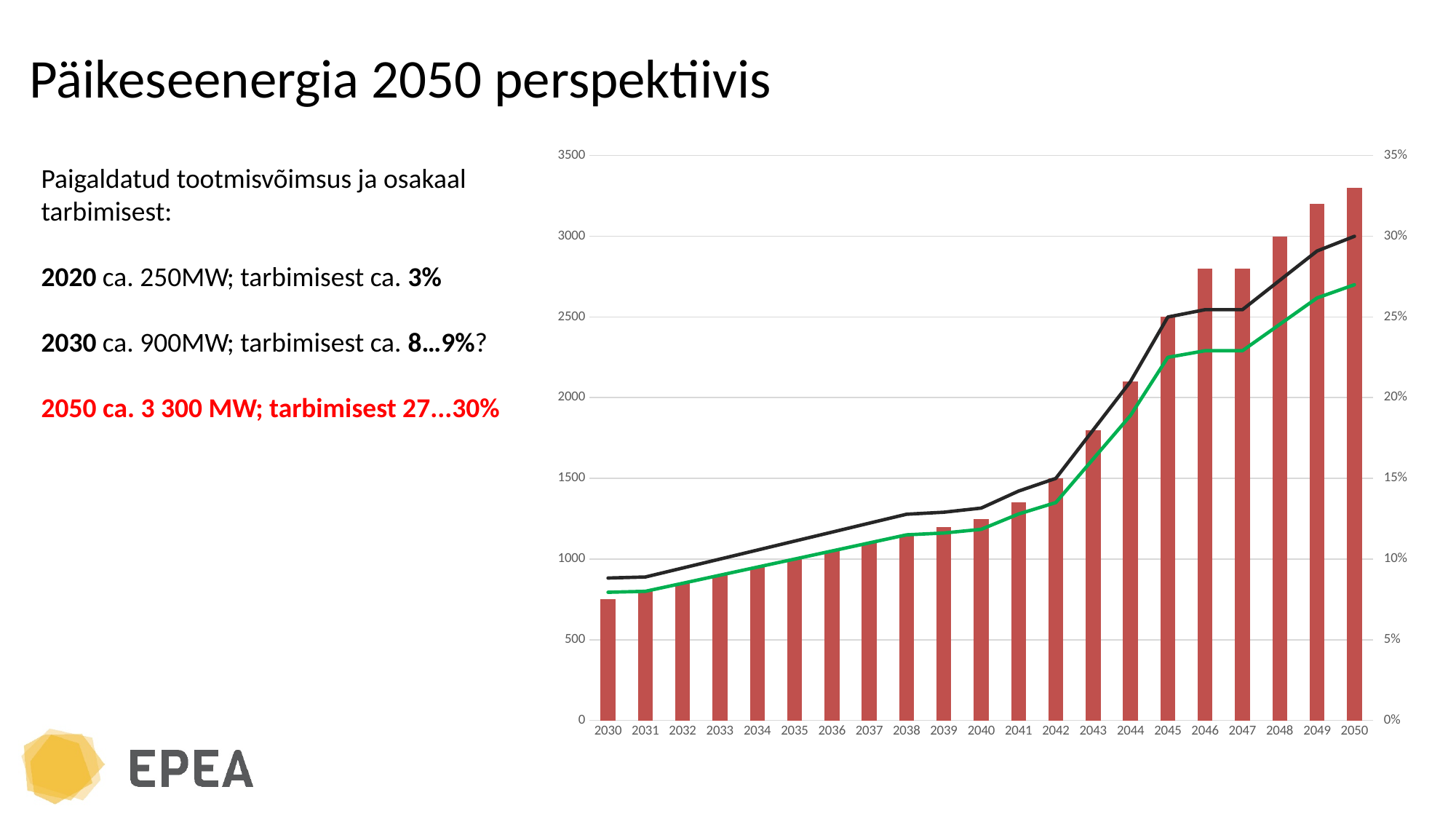
How many lines are plotted on the chart in addition to the bars? 2 What kind of chart is shown on the slide? A combined bar and line chart Is the bar value for 2030 greater or less than 1000? less Is the black line's value for 2050 on the right axis greater or less than 25%? greater Which year has the taller bar, 2048 or 2049? 2049 Is the bar value for 2046 greater or less than 2500? greater Which year has the shortest bar in the chart? 2030 How many years (bars) are plotted along the x axis of the chart? 21 Do the bar values generally rise or fall from 2030 to 2050? Rise Which year has the tallest bar in the chart? 2050